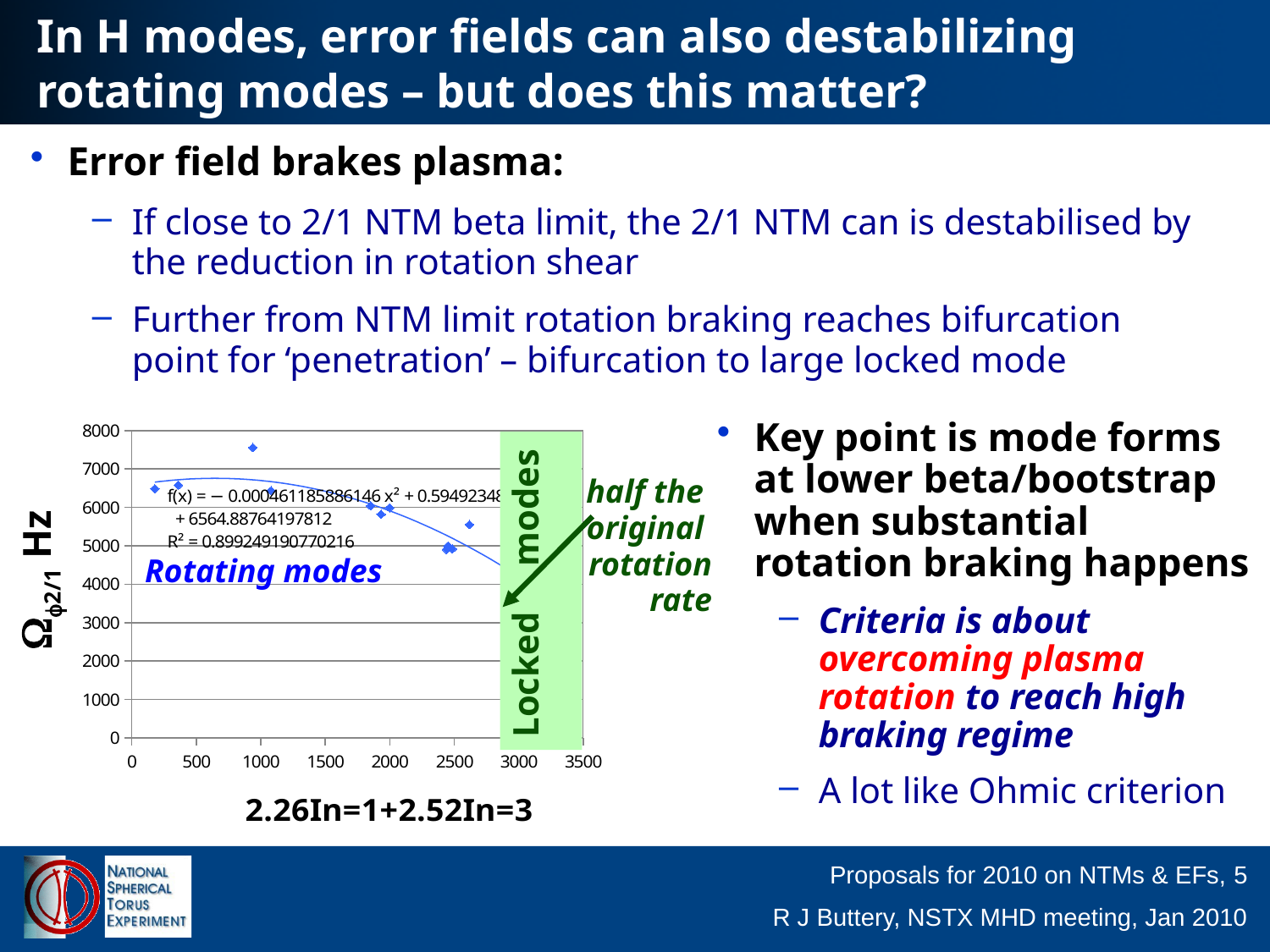
Is the value of the plotted point near x = 200 greater or less than 6000? greater Are the plotted points near x = 2500 greater or less than 6000? less What is the maximum value shown on the y axis of the chart? 8000 What is the R² value printed on the chart? 0.899249190770216 What is the coefficient of x² in the fitted trendline equation printed on the chart? −0.000461185886146 Overall, do the plotted values rise or fall as x increases from about 1000 to 2500? fall Which region of the chart is shaded green: rotating modes or locked modes? Locked modes What is the maximum value shown on the x axis of the chart? 3500 Is the highest plotted point on the chart greater or less than 7000 Hz? greater Is the plotted point near x = 950 higher or lower than the plotted points near x = 1900? higher What is the constant term of the fitted trendline equation printed on the chart? 6564.88764197812 What kind of chart is shown on the slide? scatter chart